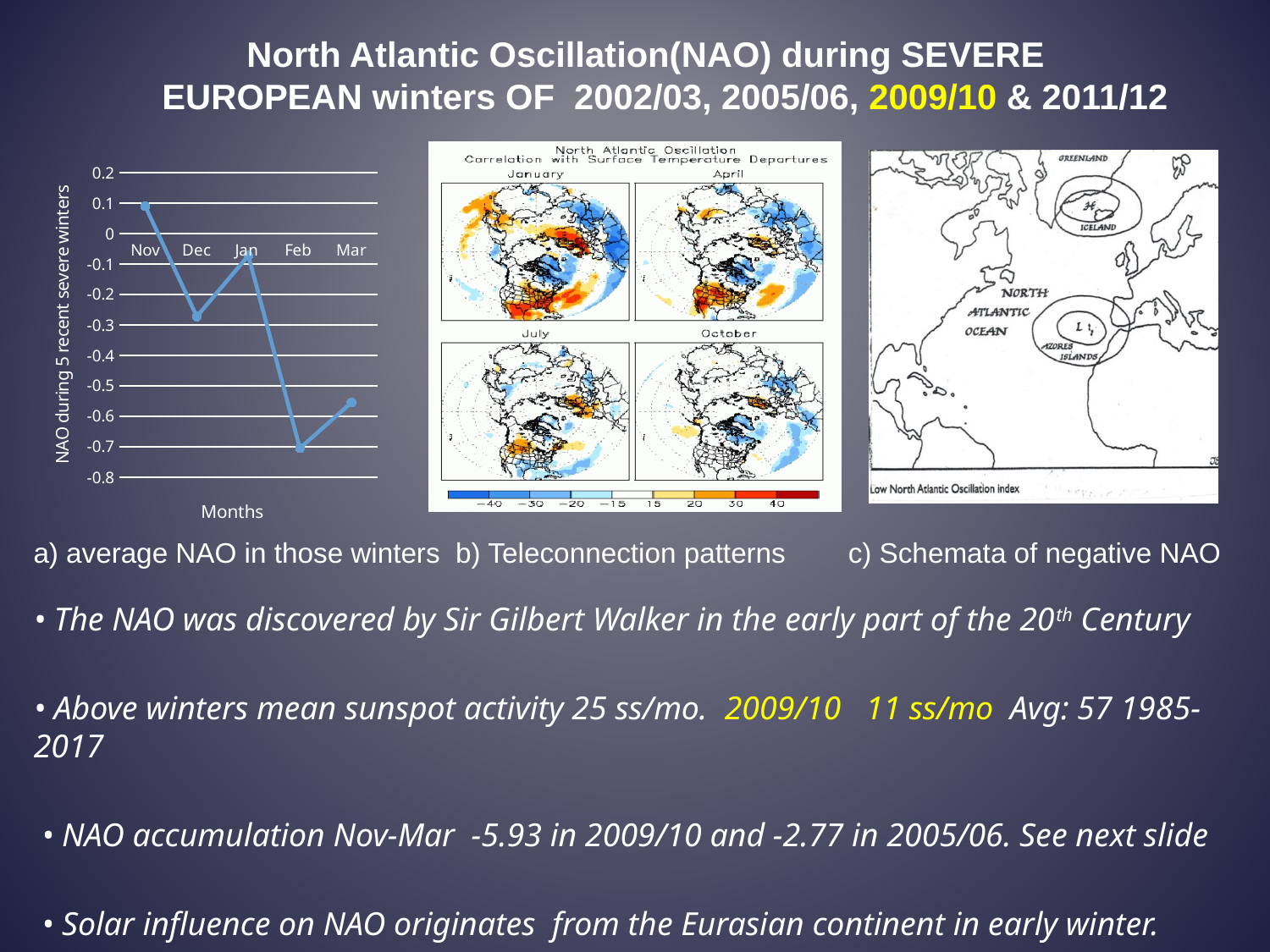
In the line chart on the left, is the value for Dec greater or less than -0.2? less In the line chart on the left, which month has the lowest NAO value? Feb In the line chart on the left, which month has the highest NAO value? Nov In the line chart on the left, what is the title of the vertical axis? NAO during 5 recent severe winters In the line chart on the left, does the NAO value rise or fall from Jan to Feb? fall In the line chart on the left, is the value for Mar greater or less than -0.5? less What kind of chart is the chart on the left of the slide? line chart In the line chart on the left, what is the title of the horizontal axis? Months In the line chart on the left, how many months are plotted along the x axis? 5 In the line chart on the left, which has the larger NAO value, Dec or Jan? Jan